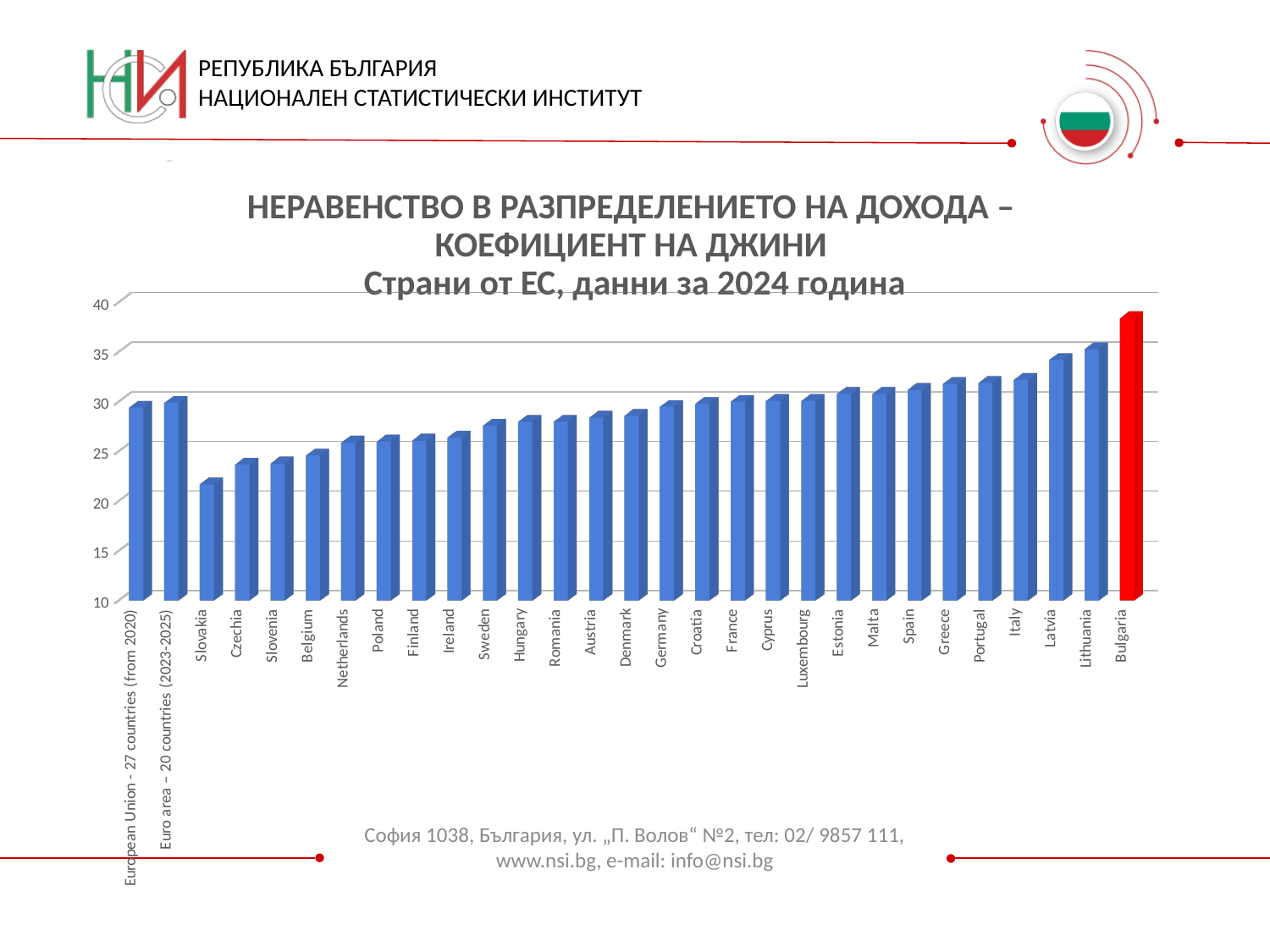
Which has the larger value, Slovakia or Czechia? Czechia Which category has the lowest Gini coefficient in the chart? Slovakia Which category has the highest Gini coefficient in the chart? Bulgaria Is the value for Italy greater or less than 30? greater Is the value for Latvia greater or less than 35? less What kind of chart is shown on the slide? bar chart Is the value for Slovakia greater or less than 25? less How many categories (bars) are plotted in the chart? 29 Do the values of the country bars generally rise or fall from left to right along the x axis? rise Which bar in the chart is coloured red rather than blue? Bulgaria